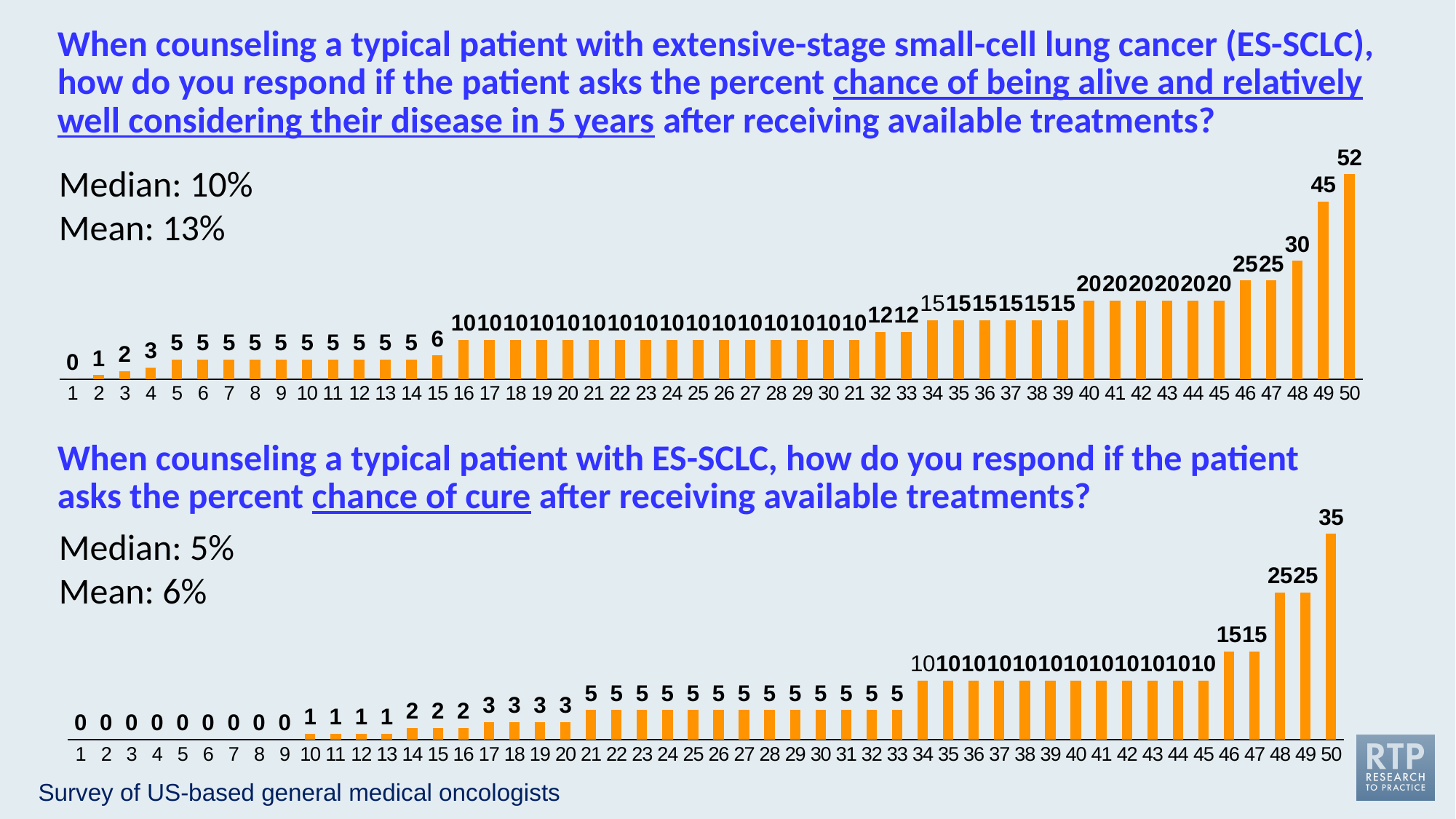
In the top chart (chance of being alive and relatively well in 5 years), what is the value for respondent 50? 52 In the top chart (chance of being alive and relatively well in 5 years), what is the value for respondent 49? 45 In the top chart (chance of being alive and relatively well in 5 years), what is the value for respondent 15? 6 In the top chart (chance of being alive and relatively well in 5 years), how many respondents are plotted? 50 In the bottom chart (chance of cure), which respondent has the highest value? 50 In the top chart (chance of being alive and relatively well in 5 years), what is the difference between the values for respondents 50 and 49? 7 In the bottom chart (chance of cure), what is the value for respondent 10? 1 What kind of chart is the bottom chart (chance of cure)? bar chart In the bottom chart (chance of cure), what is the value for respondent 50? 35 In the bottom chart (chance of cure), is the value for respondent 48 larger or smaller than the value for respondent 46? larger In the top chart (chance of being alive and relatively well in 5 years), which respondent has the highest value? 50 In the bottom chart (chance of cure), do the values rise or fall from respondent 1 to respondent 50? rise